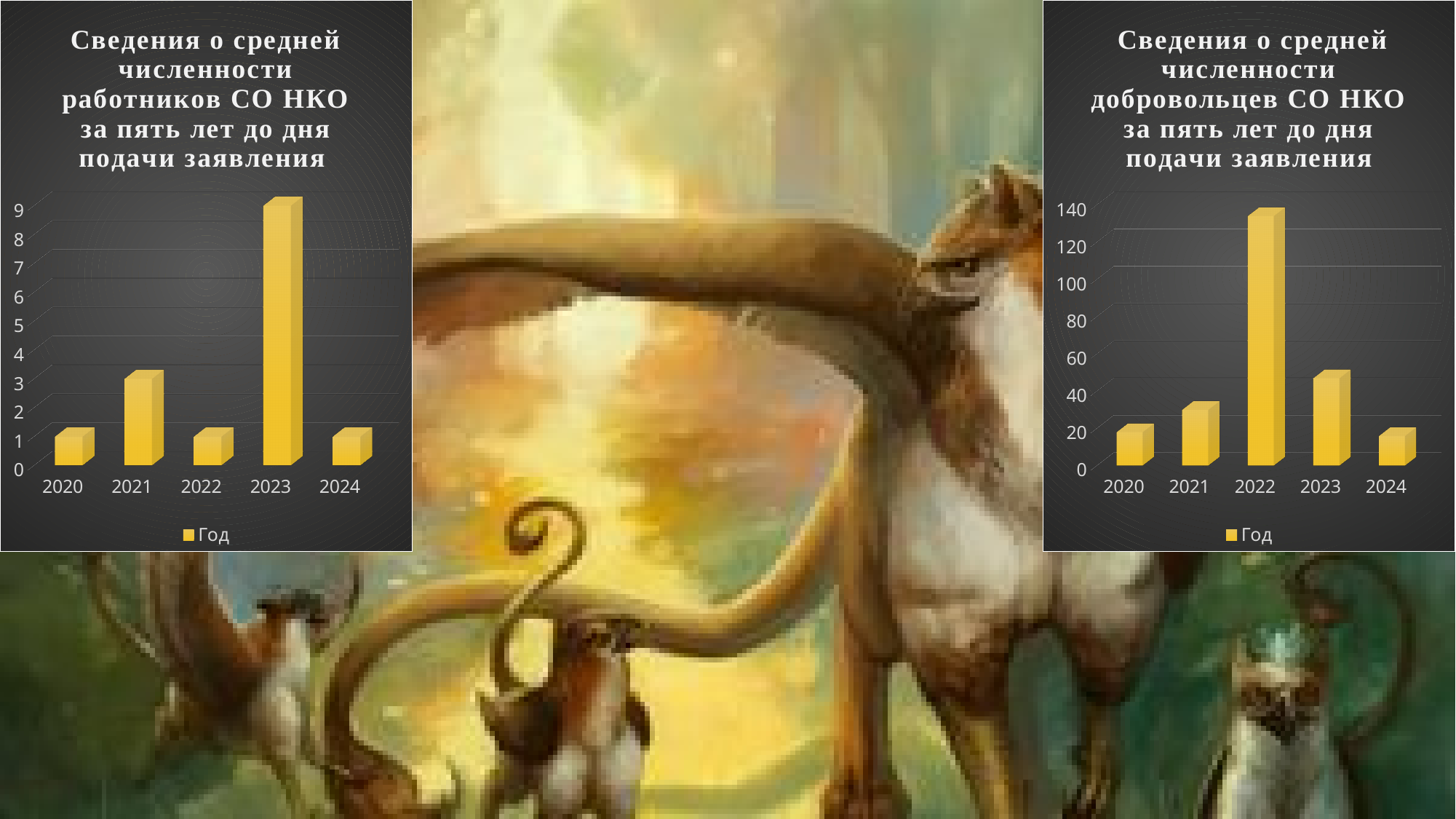
In the right chart (volunteers), is the value for 2022 greater or less than 120? greater In the left chart (workers), how many years are shown on the x axis? 5 What is the legend entry shown in the right chart (volunteers)? Год In the right chart (volunteers), which is larger, the value for 2023 or the value for 2021? 2023 In the left chart (workers), is the value for 2021 greater or less than 2? greater In the left chart (workers), which is larger, the value for 2021 or the value for 2022? 2021 In the left chart (workers), which year has the highest bar? 2023 In the left chart (workers), is the value for 2023 greater or less than 8? greater In the right chart (volunteers), which year has the highest bar? 2022 What kind of chart is the left chart, 'Сведения о средней численности работников СО НКО за пять лет до дня подачи заявления'? bar chart In the right chart (volunteers), how many series does the legend list? 1